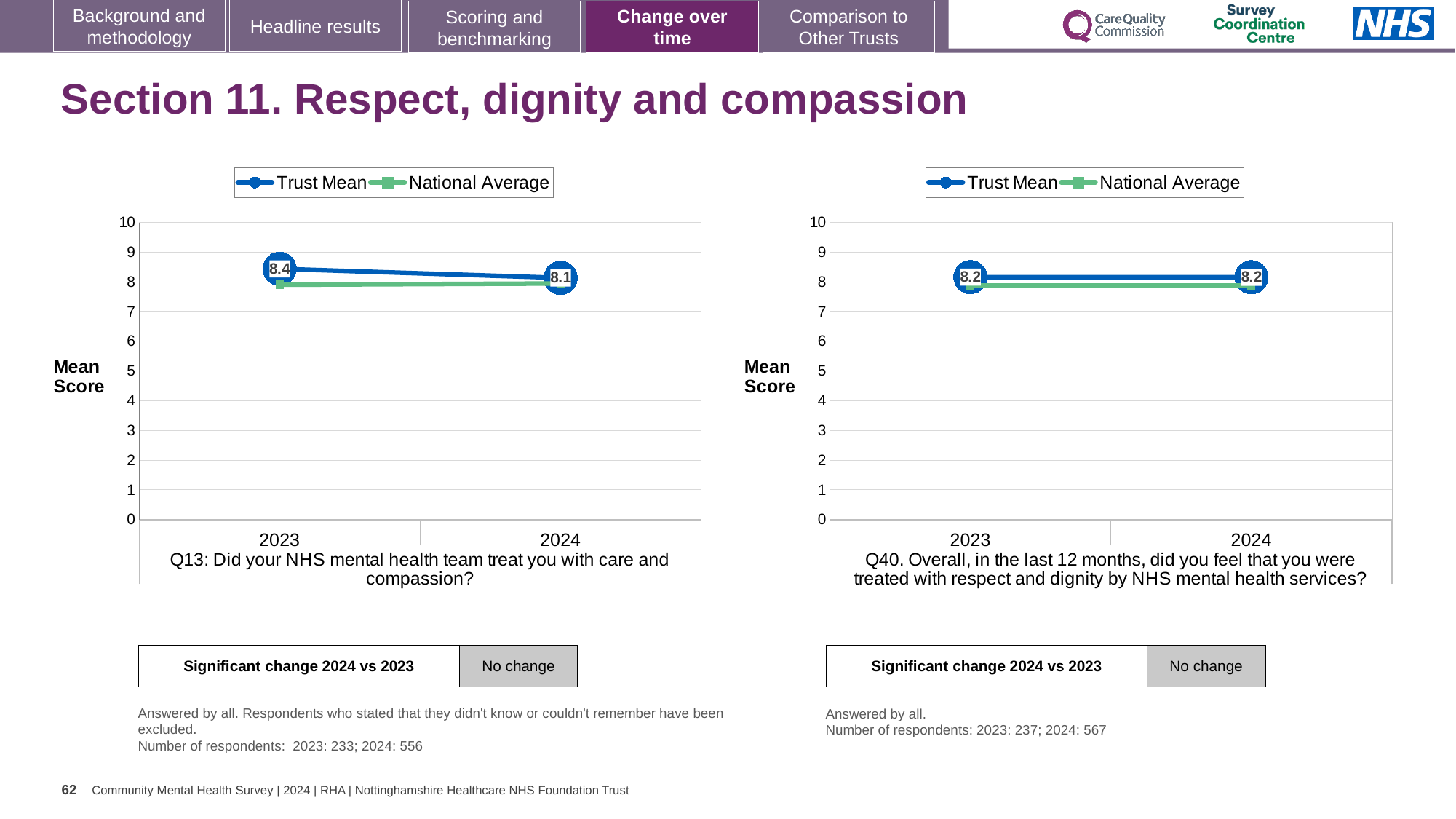
In the left chart (Q13), by how much did the Trust Mean change from 2023 to 2024? 0.3 How many years are plotted on the x axis of the left chart (Q13)? 2 What type of chart is used on the left (Q13)? line chart How many series does the legend of the right chart (Q40) list? 2 In the left chart (Q13), what is the Trust Mean score for 2024? 8.1 In the right chart (Q40), does the Trust Mean rise, fall or stay the same from 2023 to 2024? stay the same In the right chart (Q40), what is the Trust Mean score for 2024? 8.2 What is the label on the y axis of the right chart (Q40)? Mean Score In the left chart (Q13), does the Trust Mean rise or fall from 2023 to 2024? fall In the left chart (Q13), what is the Trust Mean score for 2023? 8.4 In the left chart (Q13), which is larger in 2023, the Trust Mean or the National Average? Trust Mean In the left chart (Q13), is the National Average value for 2024 greater or less than 5? greater